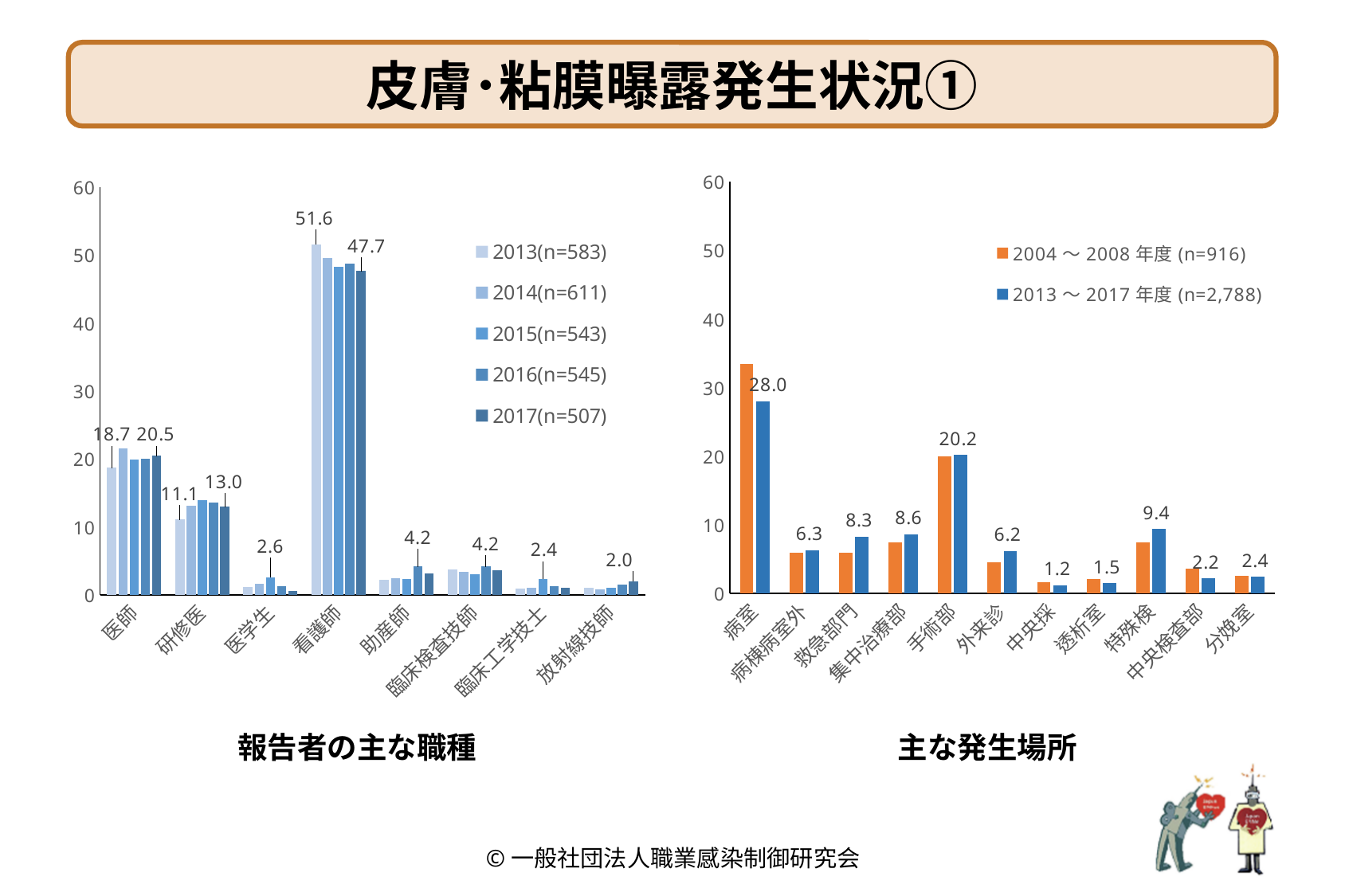
In the right chart (主な発生場所), what is the value for 手術部 in 2013～2017年度? 20.2 In the right chart (主な発生場所), which location has the highest value for 2013～2017年度? 病室 In the left chart (報告者の主な職種), how many series does the legend list? 5 What kind of chart is the left chart titled 報告者の主な職種? bar chart In the left chart (報告者の主な職種), what is the value for 看護師 in 2017? 47.7 In the left chart (報告者の主な職種), what is the value for 医師 in 2013? 18.7 In the right chart (主な発生場所), is the value for 病室 in 2004～2008年度 greater or less than 30? greater In the right chart (主な発生場所), how many series does the legend list? 2 In the left chart (報告者の主な職種), what is the value for 看護師 in 2013? 51.6 In the left chart (報告者の主な職種), what is the difference between the 看護師 values for 2013 and 2017? 3.9 In the left chart (報告者の主な職種), how many occupation categories are shown on the x axis? 8 In the left chart (報告者の主な職種), which occupation has the highest values? 看護師